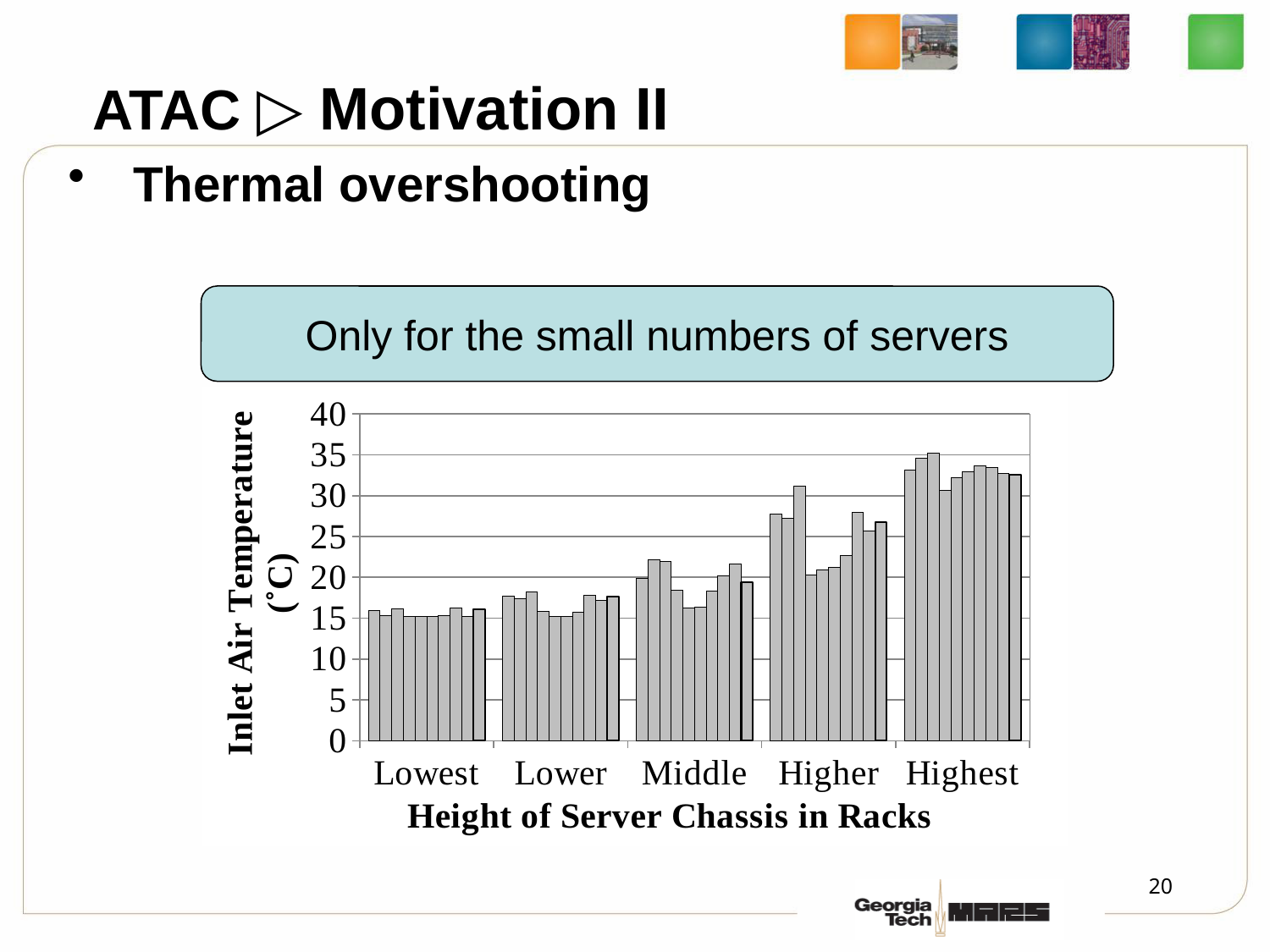
Are the bars for the Middle category greater or less than 25? less Are the bars for the Lower category greater or less than 20? less What is the label of the y axis? Inlet Air Temperature (°C) Which height category has the lowest inlet air temperatures? Lowest What is the label of the x axis? Height of Server Chassis in Racks What kind of chart is shown on the slide? bar chart Are the bars for the Lowest category greater or less than 20? less How many height categories are shown on the x axis? 5 Which height category has the highest inlet air temperatures? Highest Which category has larger inlet air temperatures, Middle or Higher? Higher Do the inlet air temperatures generally rise or fall as the height of the server chassis increases from Lowest to Highest? rise